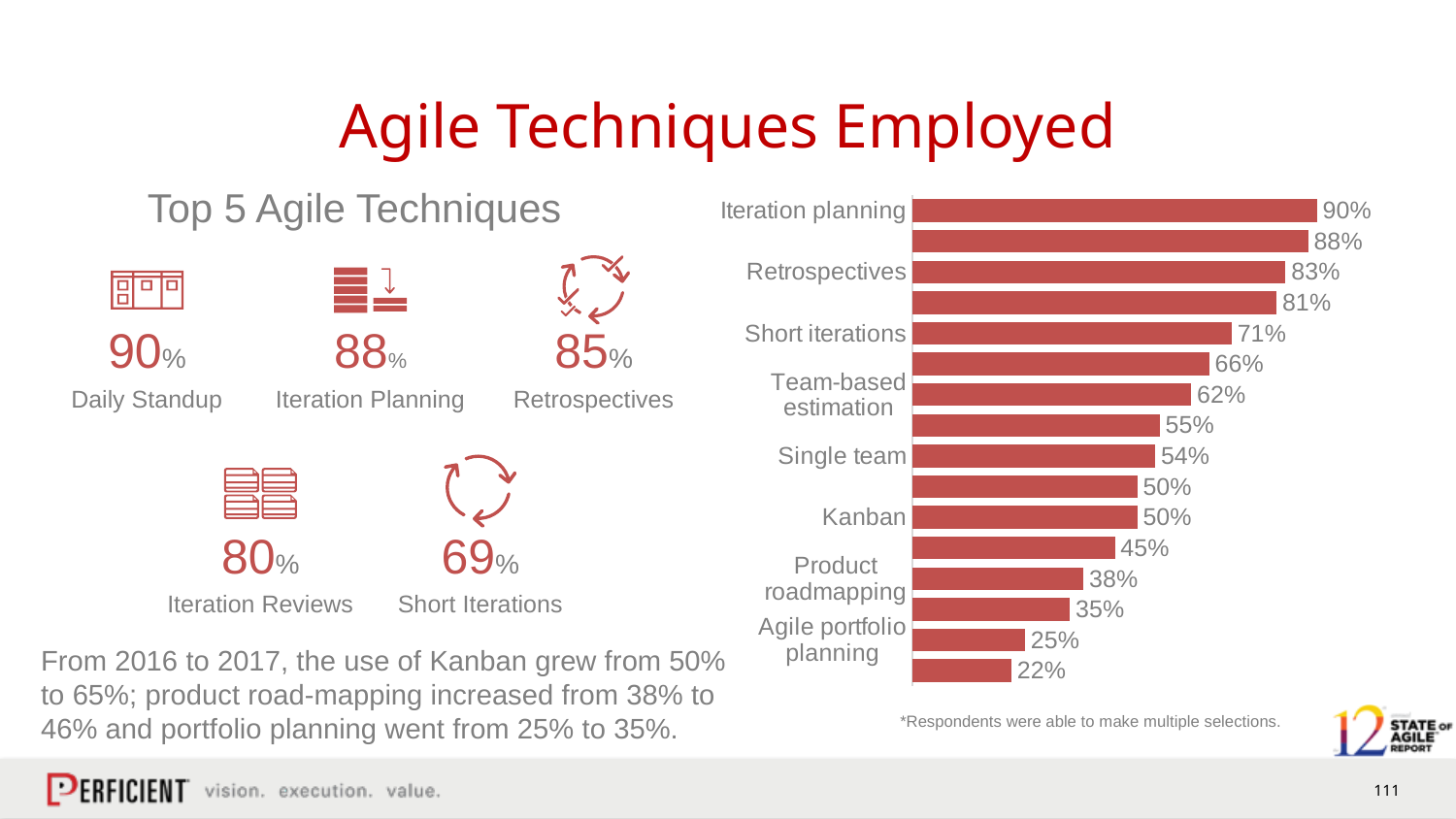
In the bar chart, which labeled category has the highest value? Iteration planning In the bar chart, what is the difference between the values for Iteration planning and Kanban? 40 percentage points In the bar chart, what is the value for Agile portfolio planning? 25% In the bar chart, what is the smallest value shown on any bar? 22% How many bars are plotted in the bar chart? 16 What type of chart is shown on the right side of the slide? Bar chart In the bar chart, what is the value for Iteration planning? 90% In the bar chart, what is the value for Short iterations? 71% In the bar chart, what is the value for Kanban? 50% What colour are the bars in the bar chart? Red In the bar chart, what is the value for Retrospectives? 83% In the bar chart, which is larger: the value for Team-based estimation or the value for Single team? Team-based estimation